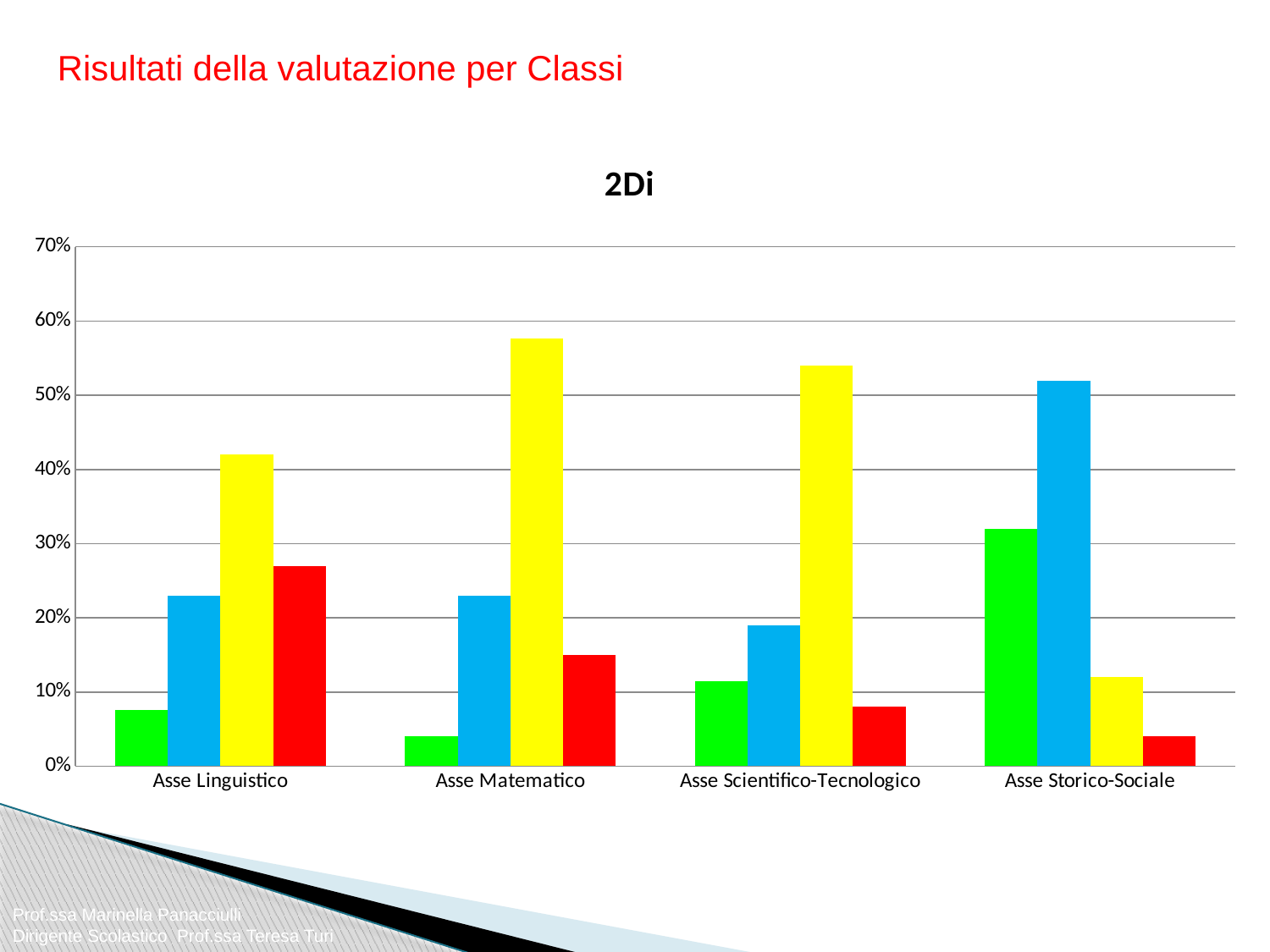
Is the green bar for Asse Storico-Sociale greater or less than 30%? greater Is the blue bar for Asse Linguistico greater or less than 20%? greater Is the yellow bar for Asse Matematico greater or less than 50%? greater For Asse Linguistico, which is larger: the yellow bar or the red bar? yellow Which colour bar is the tallest for Asse Storico-Sociale? blue Which colour bar is the shortest for Asse Matematico? green What is the title of the chart? 2Di In which category is the yellow bar the tallest? Asse Matematico What kind of chart is shown on the slide? bar chart How many categories are shown on the x axis of the chart? 4 How many bars are shown for each category in the chart? 4